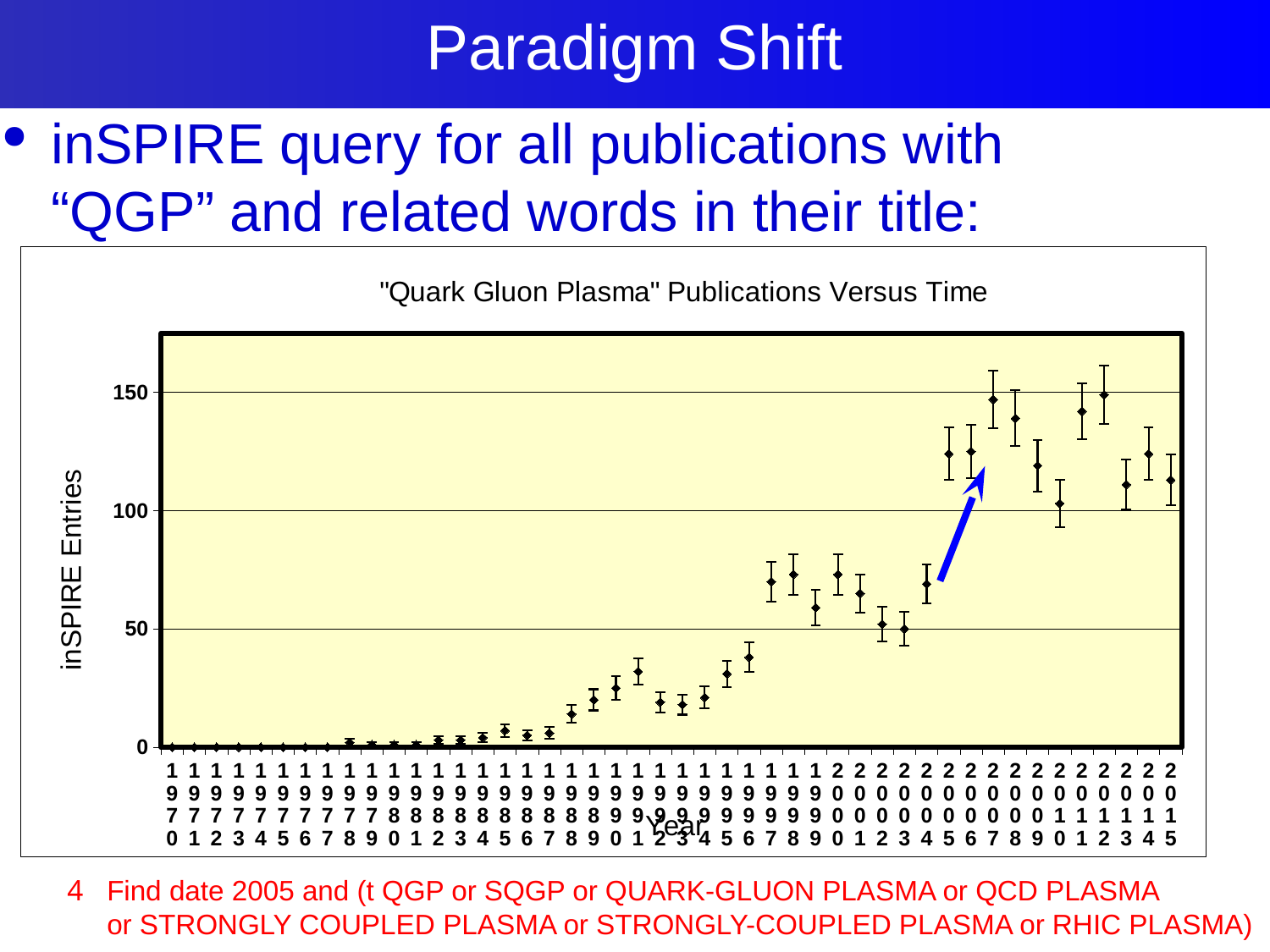
What is the title of the chart? "Quark Gluon Plasma" Publications Versus Time How many years (data points) are plotted along the x axis? 46 Is the value for 1990 greater or less than 50? less What kind of chart is shown on the slide? Scatter plot with error bars Is the value for 2003 greater or less than 100? less Is the value for 1997 greater or less than 50? greater What is the label on the y axis of the chart? inSPIRE Entries Which year has the larger value, 2007 or 2003? 2007 Do the values generally rise or fall from 1970 to 2015? rise